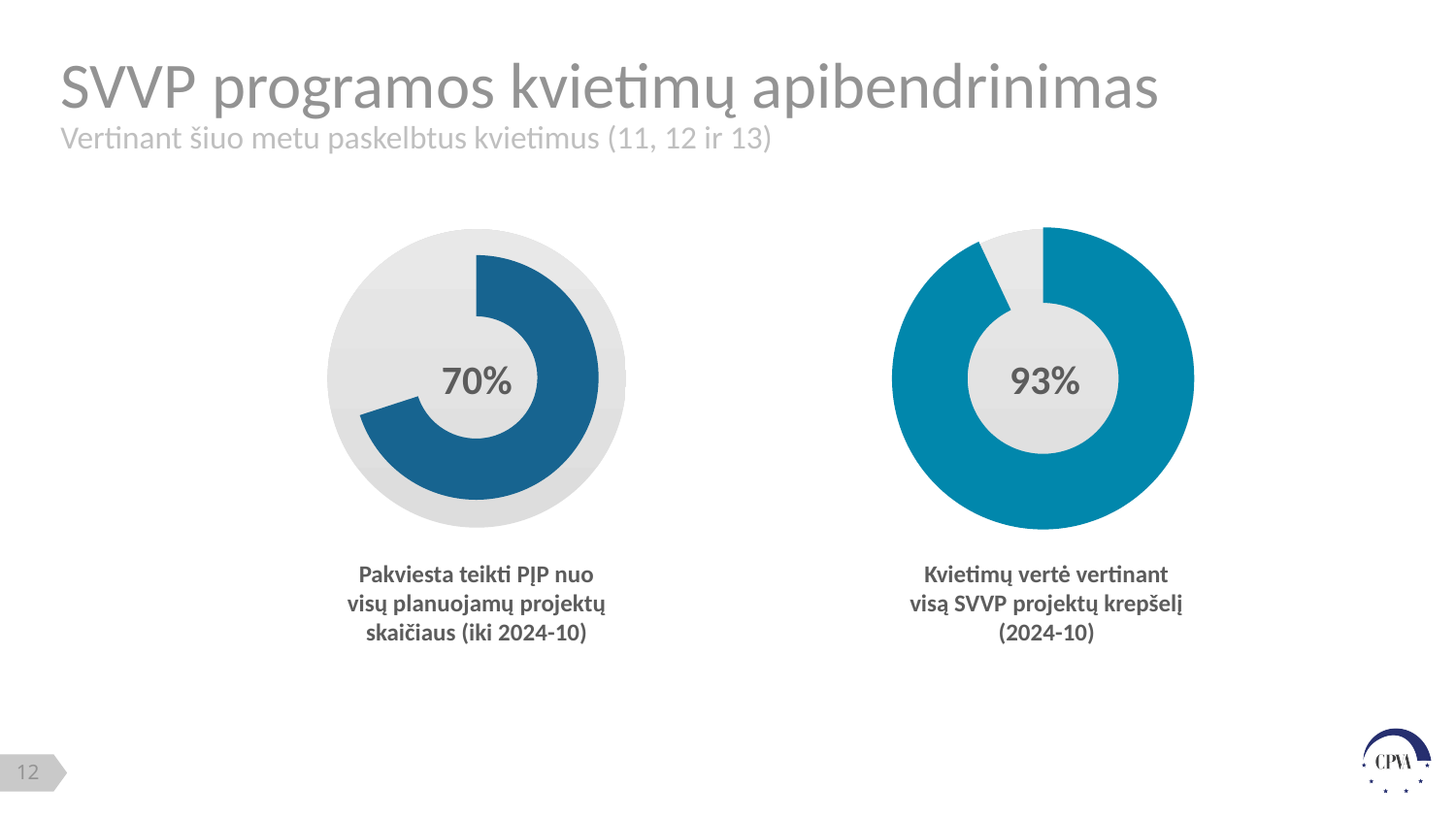
Is the value shown in the left donut chart greater or less than 50%? greater What percentage is shown in the centre of the left donut chart (Pakviesta teikti PĮP nuo visų planuojamų projektų skaičiaus)? 70% What is the title of the slide containing the two donut charts? SVVP programos kvietimų apibendrinimas In the left donut chart, what share of the ring is left unfilled (grey) if the filled portion is 70%? 30% In the right donut chart, what share of the ring is left unfilled (grey) if the filled portion is 93%? 7% What is the caption under the right donut chart? Kvietimų vertė vertinant visą SVVP projektų krepšelį (2024-10) How many donut charts are shown on the slide? 2 What is the difference in percentage points between the right chart's value (93%) and the left chart's value (70%)? 23 percentage points What kind of chart is used on the right side of the slide? Donut chart Which chart shows the larger percentage, the left one (70%) or the right one (93%)? The right chart (93%) What kind of chart is used on the left side of the slide? Donut chart What percentage is shown in the centre of the right donut chart (Kvietimų vertė vertinant visą SVVP projektų krepšelį)? 93%